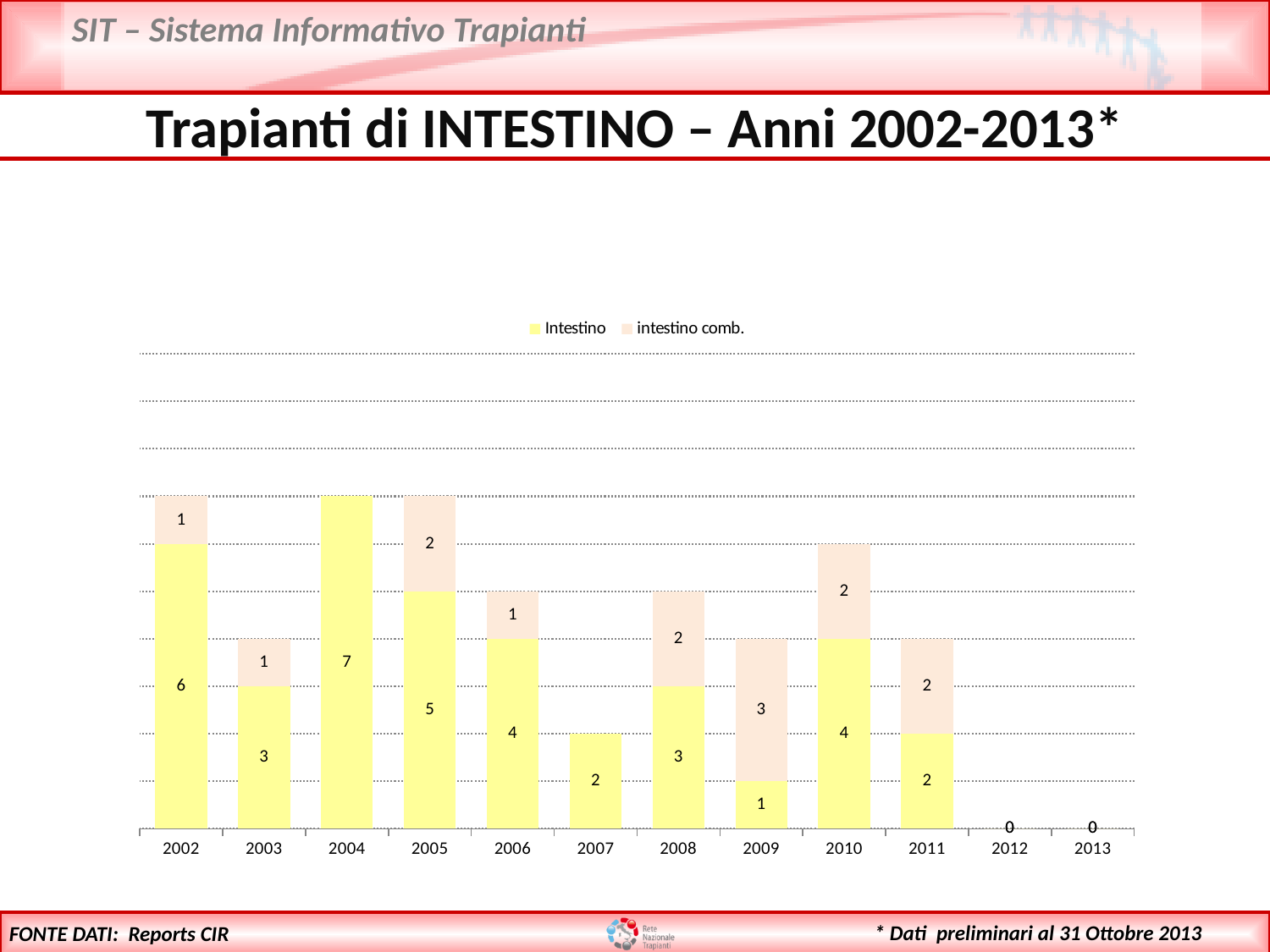
Which year has the highest Intestino value? 2004 In 2009, which is larger: the Intestino value or the intestino comb. value? intestino comb. What is the Intestino value for 2011? 2 What is the total of the stacked bar for 2010? 6 What is the Intestino value for 2002? 6 What is the total of the stacked bar for 2005? 7 What kind of chart is shown on the slide? Stacked bar chart How many series does the legend list? 2 What is the intestino comb. value for 2009? 3 What is the difference between the Intestino values for 2002 and 2003? 3 How many years are shown on the x axis? 12 Among the years 2002 to 2011, which year has the lowest Intestino value? 2009